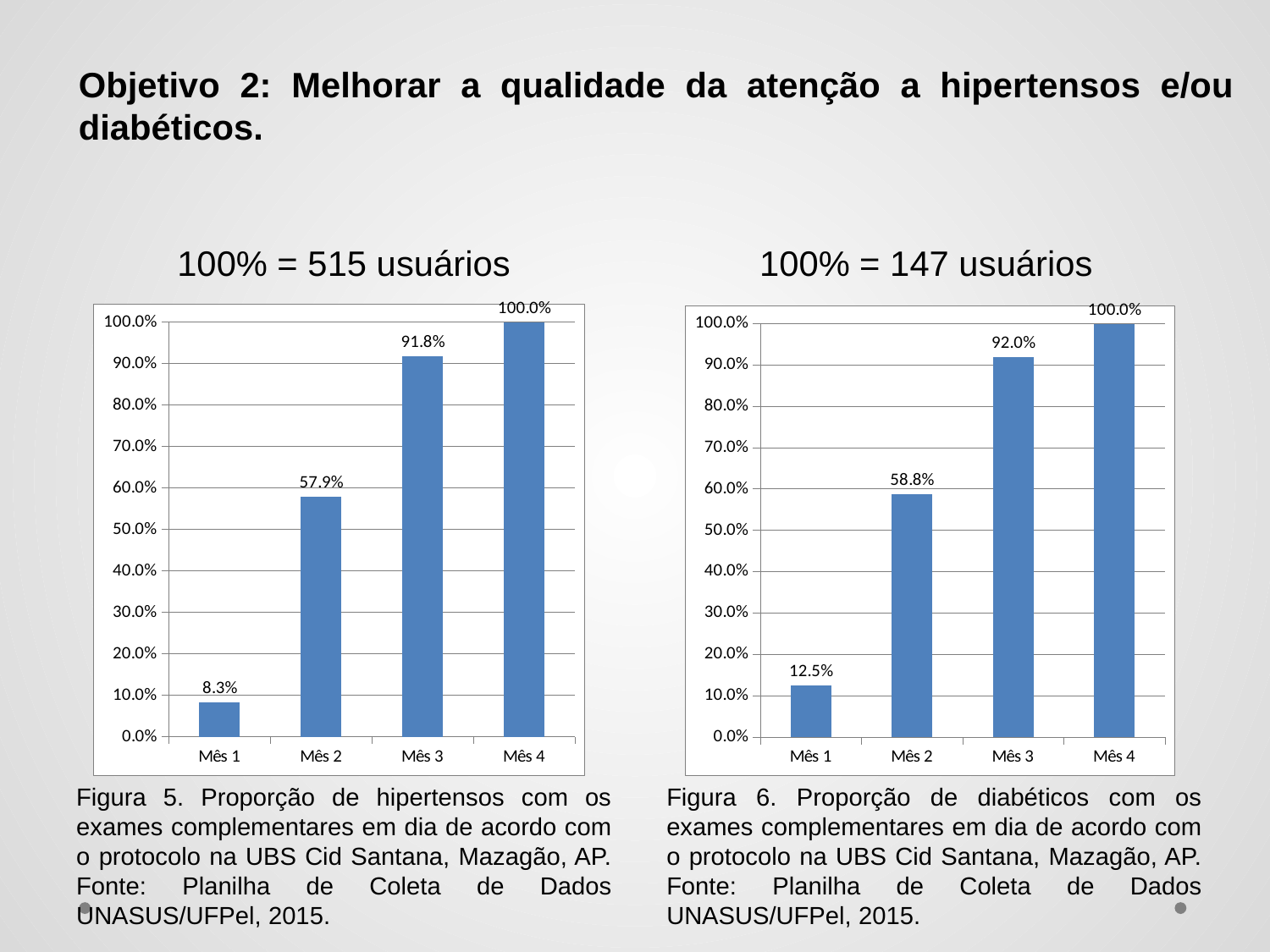
In the right chart (Figura 6, diabéticos), do the values rise or fall from Mês 1 to Mês 4? Rise How many months (categories) are shown in the right chart (Figura 6, diabéticos)? 4 In the left chart (Figura 5, hipertensos), which month has the lowest value? Mês 1 What type of chart is the left chart (Figura 5, hipertensos)? Bar chart According to the text above the right chart (Figura 6), how many users correspond to 100%? 147 usuários In the right chart (Figura 6, diabéticos), which month has the highest value? Mês 4 In the left chart (Figura 5, hipertensos), what is the value for Mês 2? 57.9% In the right chart (Figura 6, diabéticos), what is the value for Mês 1? 12.5% In the right chart (Figura 6, diabéticos), what is the difference between Mês 2 and Mês 1? 46.3% In the left chart (Figura 5, hipertensos), what is the difference between Mês 3 and Mês 2? 33.9% Which is larger: Mês 3 in the left chart (Figura 5) or Mês 3 in the right chart (Figura 6)? Mês 3 in the right chart (Figura 6) In the left chart (Figura 5, hipertensos), is the value for Mês 2 greater or less than 50.0%? greater